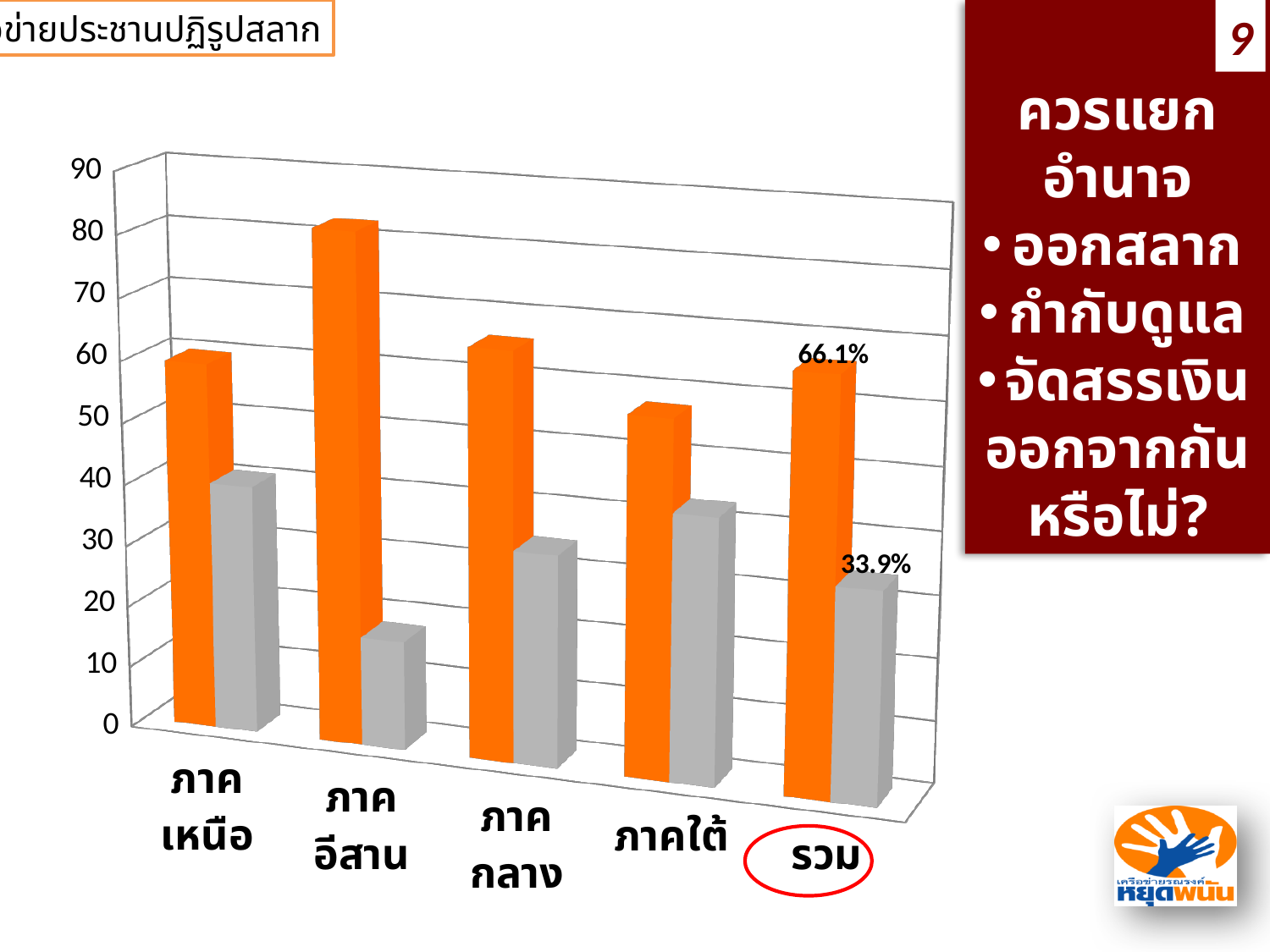
Which category has the shortest grey bar? ภาคอีสาน What is the difference between the orange and grey values for รวม? 32.2 percentage points Which category has the shortest orange bar? ภาคใต้ What is the value shown on the grey bar for รวม? 33.9% Is the orange bar for ภาคอีสาน greater or less than 70? greater Is the grey bar for ภาคอีสาน greater or less than 20? less Which has the taller grey bar, ภาคเหนือ or ภาคอีสาน? ภาคเหนือ Which has the taller orange bar, ภาคเหนือ or ภาคอีสาน? ภาคอีสาน What is the value shown on the orange bar for รวม? 66.1% Which category has the tallest orange bar? ภาคอีสาน What kind of chart is shown on the slide? bar chart How many categories are shown on the x axis? 5